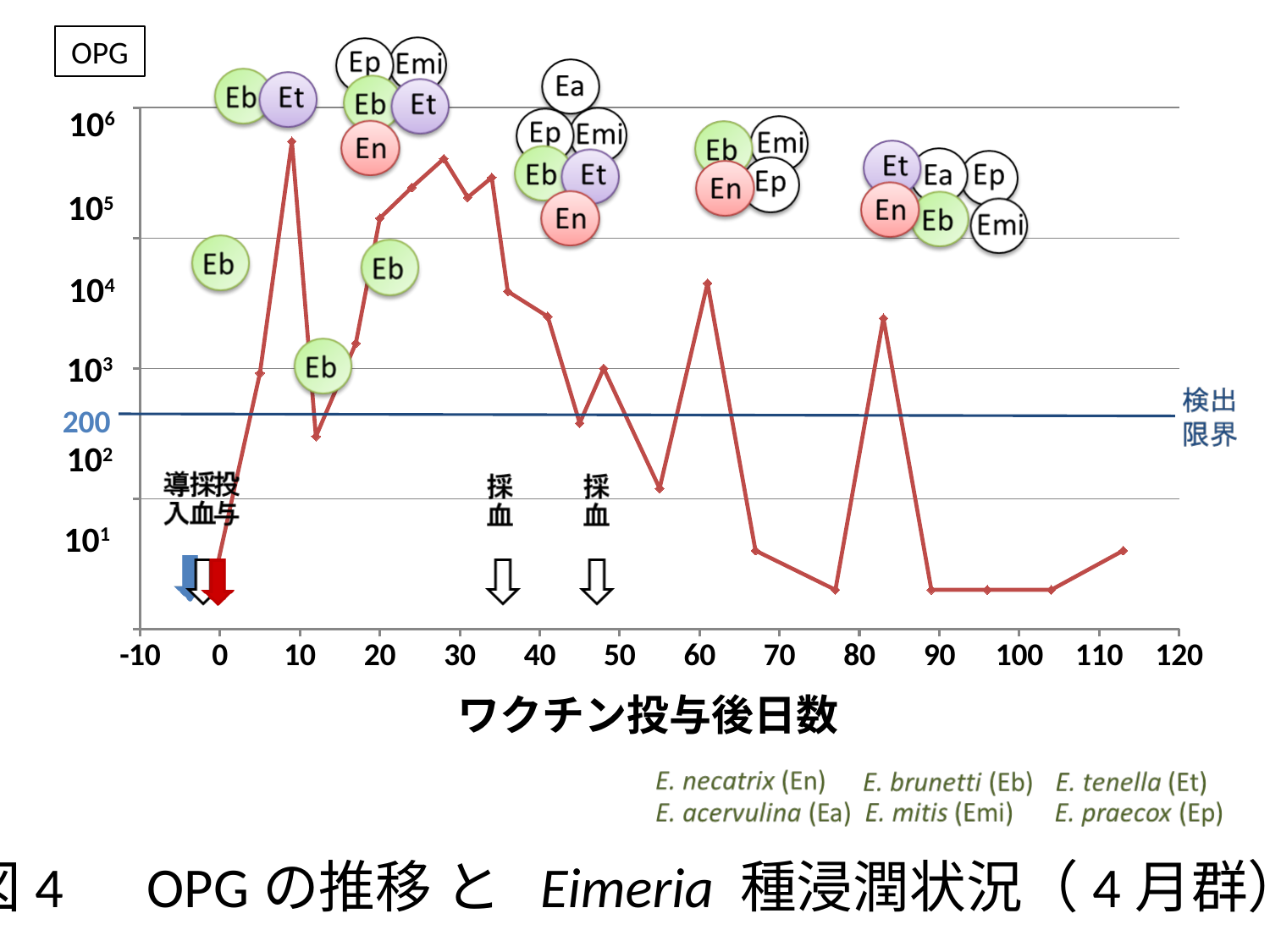
Is the OPG value at about day 83 greater or less than 10^3? greater Is the OPG value at about day 55 greater or less than 10^2? less What is the x-axis title of the chart? ワクチン投与後日数 Is the OPG value at about day 28 greater or less than 10^5? greater Between about day 34 and about day 55, does the OPG value rise or fall overall? fall Which has the higher OPG value, the point at about day 20 or the point at about day 28? day 28 What OPG value is marked as the detection limit (検出限界) by the horizontal line? 200 What kind of chart is shown on the slide? line chart Which has the higher OPG value, the point at about day 61 or the point at about day 83? day 61